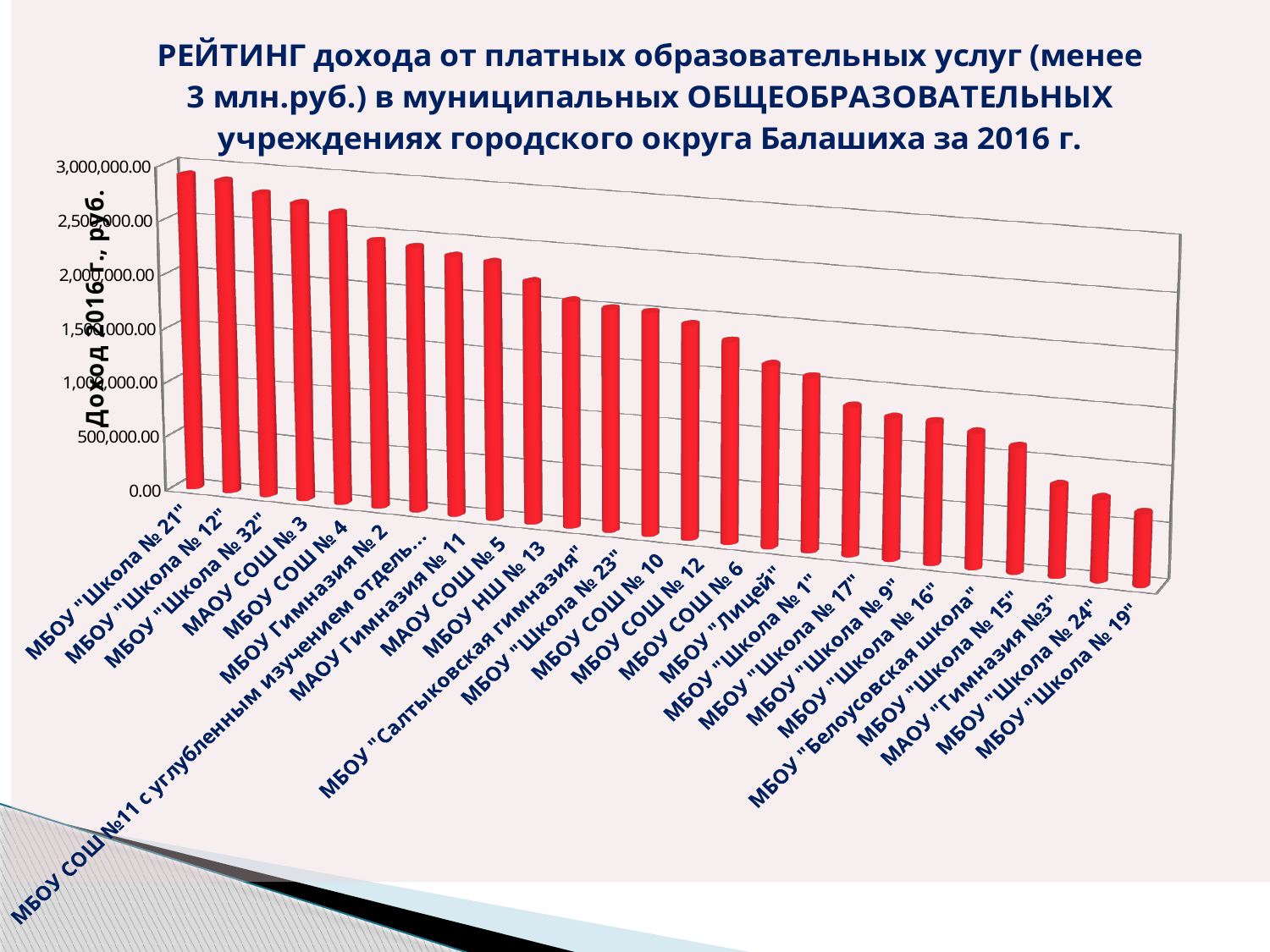
Which institution has the highest income from paid educational services in the chart? МБОУ "Школа № 21" Is the value for МБОУ Гимназия № 2 greater or less than 2,500,000.00? less Do the values rise or fall moving from left to right along the x axis? fall Which institution has the lowest income from paid educational services in the chart? МБОУ "Школа № 19" Which has the larger value: МБОУ "Школа № 32" or МБОУ "Школа № 15"? МБОУ "Школа № 32" How many educational institutions (bars) are shown in the chart? 25 What kind of chart is shown on the slide? bar chart Is the value for МБОУ "Школа № 21" greater or less than 2,500,000.00? greater What is the label of the vertical axis of the chart? Доход 2016 г., руб. Which has the larger value: МБОУ "Школа № 24" or МБОУ СОШ № 6? МБОУ СОШ № 6